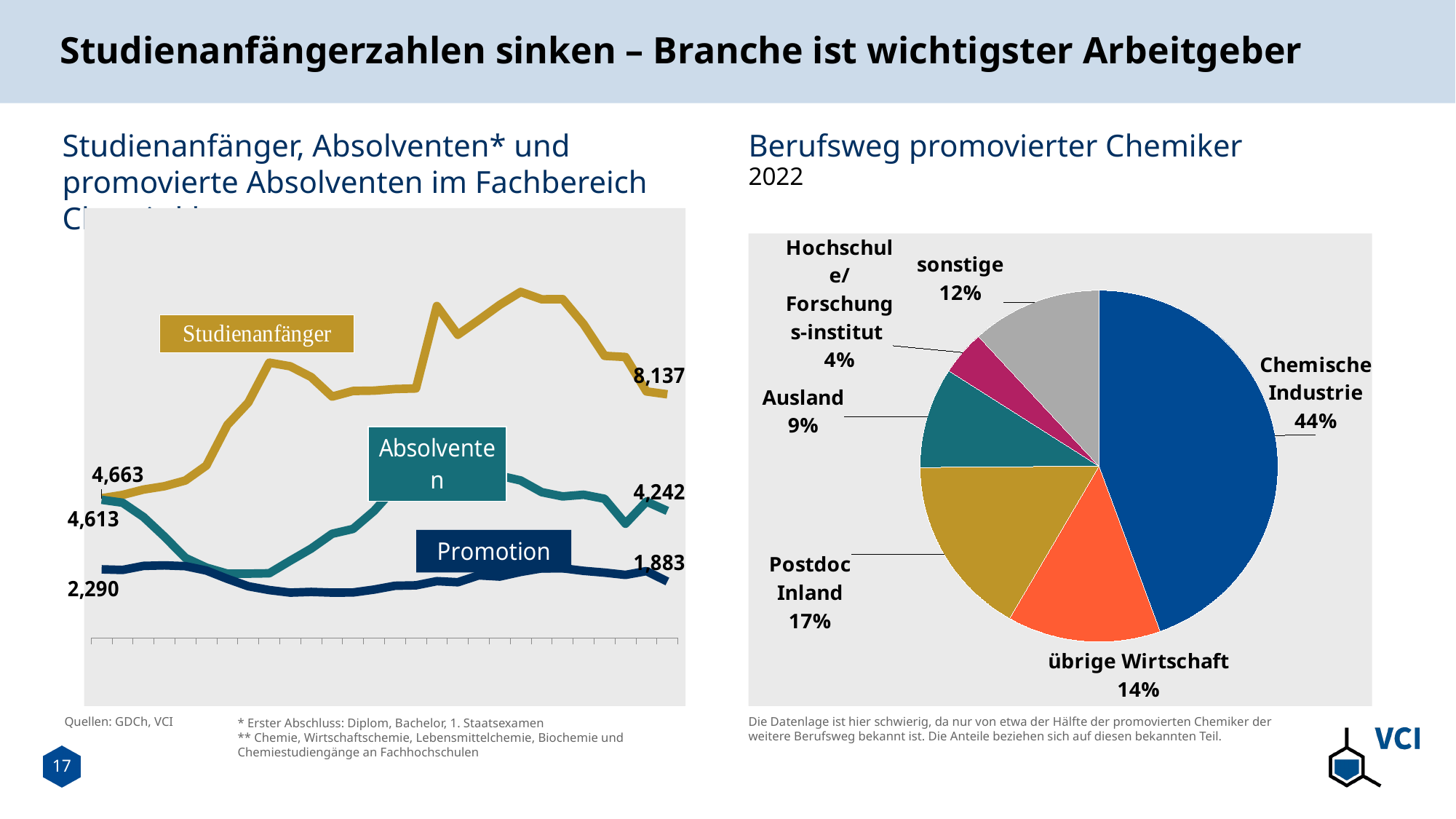
In the pie chart 'Berufsweg promovierter Chemiker 2022', how many percentage points larger is Postdoc Inland than übrige Wirtschaft? 3 percentage points What kind of chart is the chart on the left of the slide (Studienanfänger, Absolventen und promovierte Absolventen)? Line chart What kind of chart is the chart on the right of the slide ('Berufsweg promovierter Chemiker 2022')? Pie chart How many slices does the pie chart 'Berufsweg promovierter Chemiker 2022' have? 6 In the pie chart 'Berufsweg promovierter Chemiker 2022', which is larger: Ausland or sonstige? sonstige In the line chart on the left of the slide, by how much does the Studienanfänger series increase from its first labelled value (4,663) to its last labelled value (8,137)? 3,474 In the pie chart 'Berufsweg promovierter Chemiker 2022', which category has the smallest slice? Hochschule/Forschungsinstitut In the pie chart 'Berufsweg promovierter Chemiker 2022', which category has the largest slice? Chemische Industrie In the pie chart 'Berufsweg promovierter Chemiker 2022', what share is labelled for Chemische Industrie? 44% In the line chart on the left of the slide, does the Promotion series rise or fall from its first labelled value to its last labelled value? Fall In the line chart on the left of the slide, what is the last labelled value of the Studienanfänger series? 8,137 How many series are plotted in the line chart on the left of the slide? 3